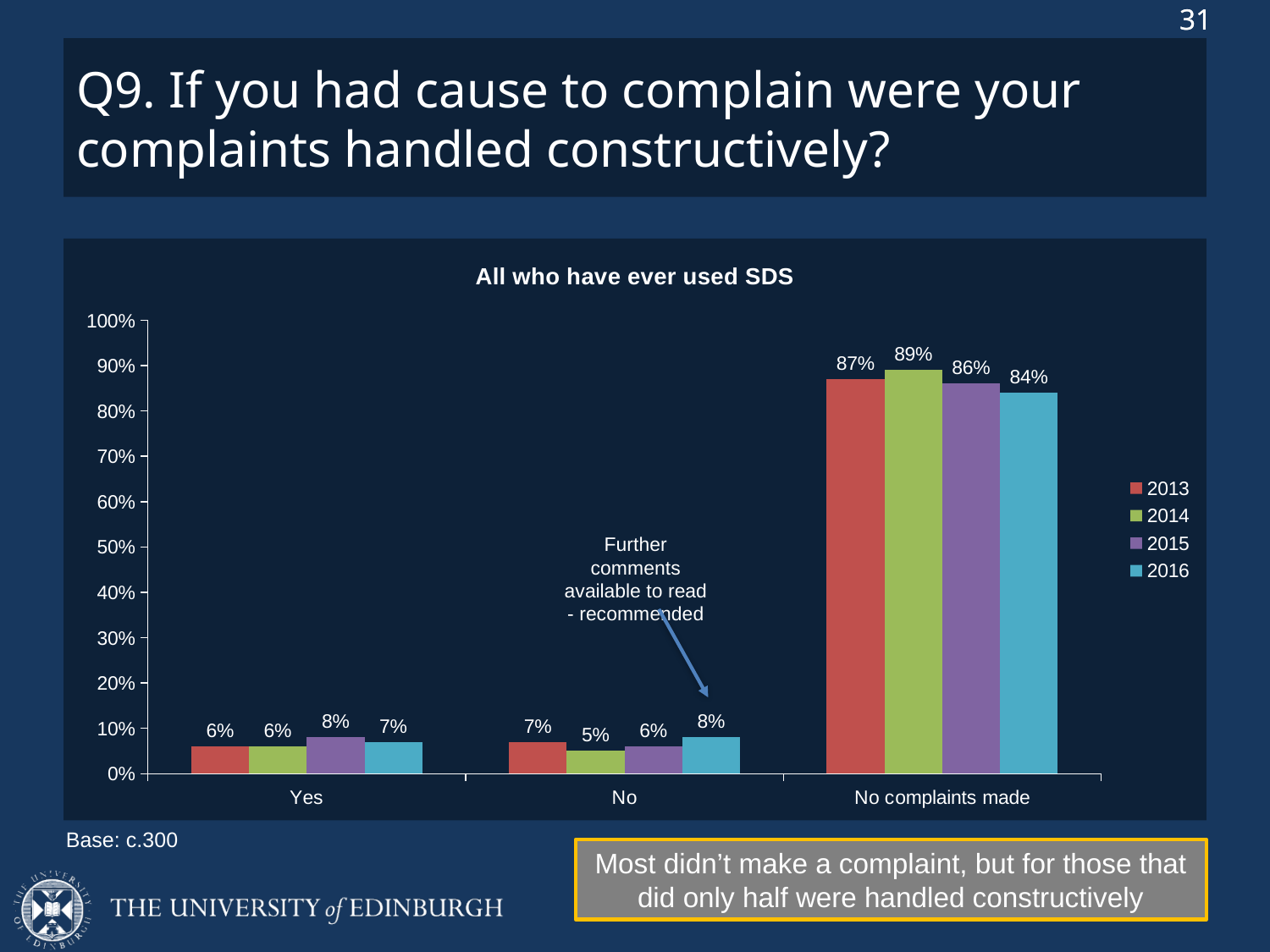
What is the value for 2016 in the 'No complaints made' category? 84% How many series does the legend list? 4 How many categories are shown on the x axis? 3 What kind of chart is shown on the slide? Bar chart Which year has the lowest value in the 'No' category? 2014 Is the value for 2015 in 'No complaints made' greater or less than 80%? greater What is the value for 2015 in the 'Yes' category? 8% Which is larger: the 2013 value for 'Yes' or the 2013 value for 'No'? No What is the difference between the 2014 and 2016 values in the 'No complaints made' category? 5% Which year has the highest value in the 'No complaints made' category? 2014 What is the title of the chart? All who have ever used SDS What is the value for 2014 in the 'No' category? 5%